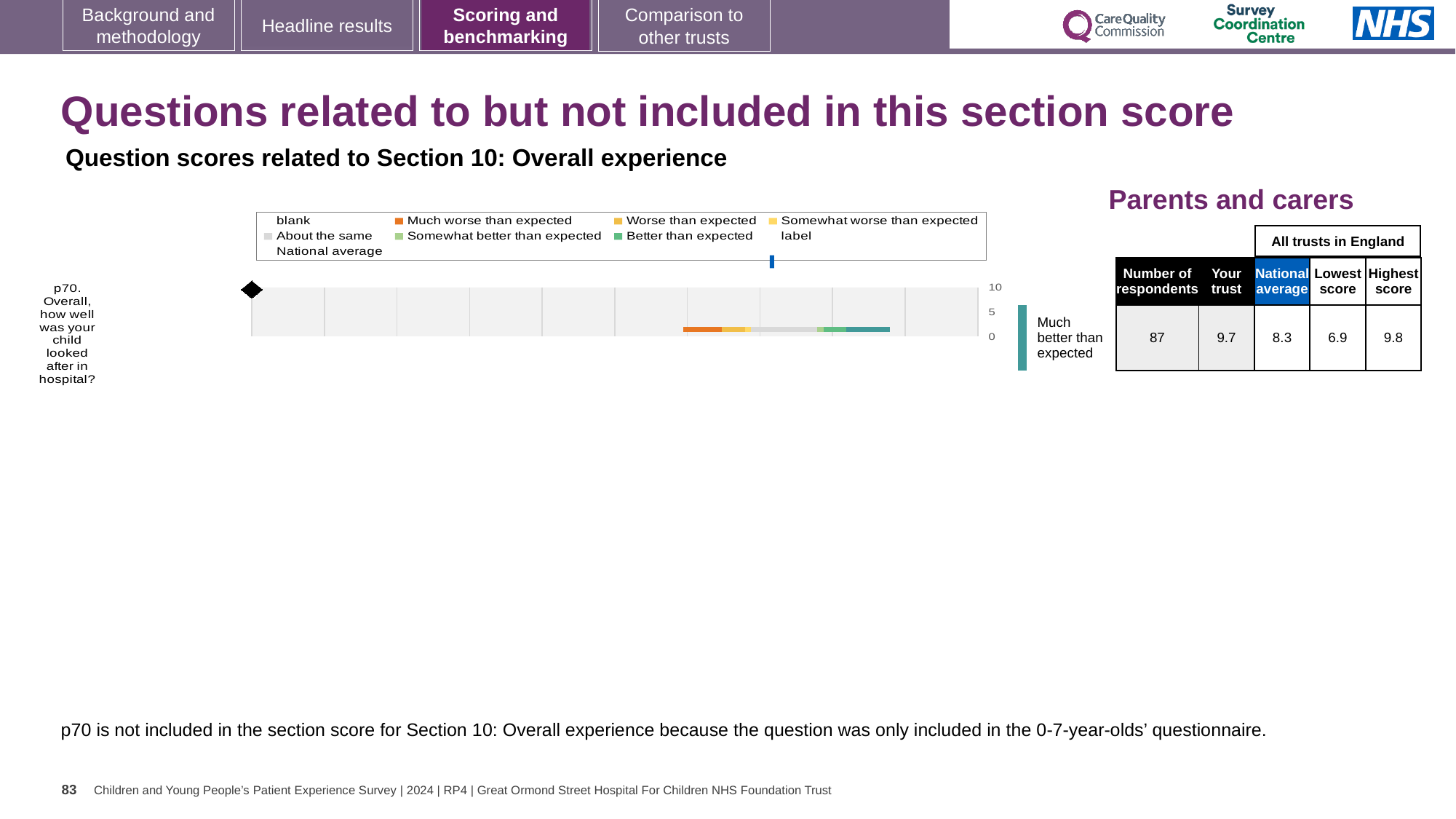
How many questions are plotted in the chart? 1 Which is larger for p70, the trust's score or the national average? Your trust What is the maximum value shown on the chart's score axis? 10 What is the National average score for p70? 8.3 What benchmark category is the trust's p70 result labelled as? Much better than expected Which question is plotted in the chart? p70. Overall, how well was your child looked after in hospital? How many respondents answered p70? 87 What is the Lowest score across all trusts in England for p70? 6.9 What kind of chart is used to show the p70 question score? bar chart What is the 'Your trust' score for p70 in the Parents and carers table? 9.7 What is the Highest score across all trusts in England for p70? 9.8 What is the difference between the trust's score and the national average for p70? 1.4